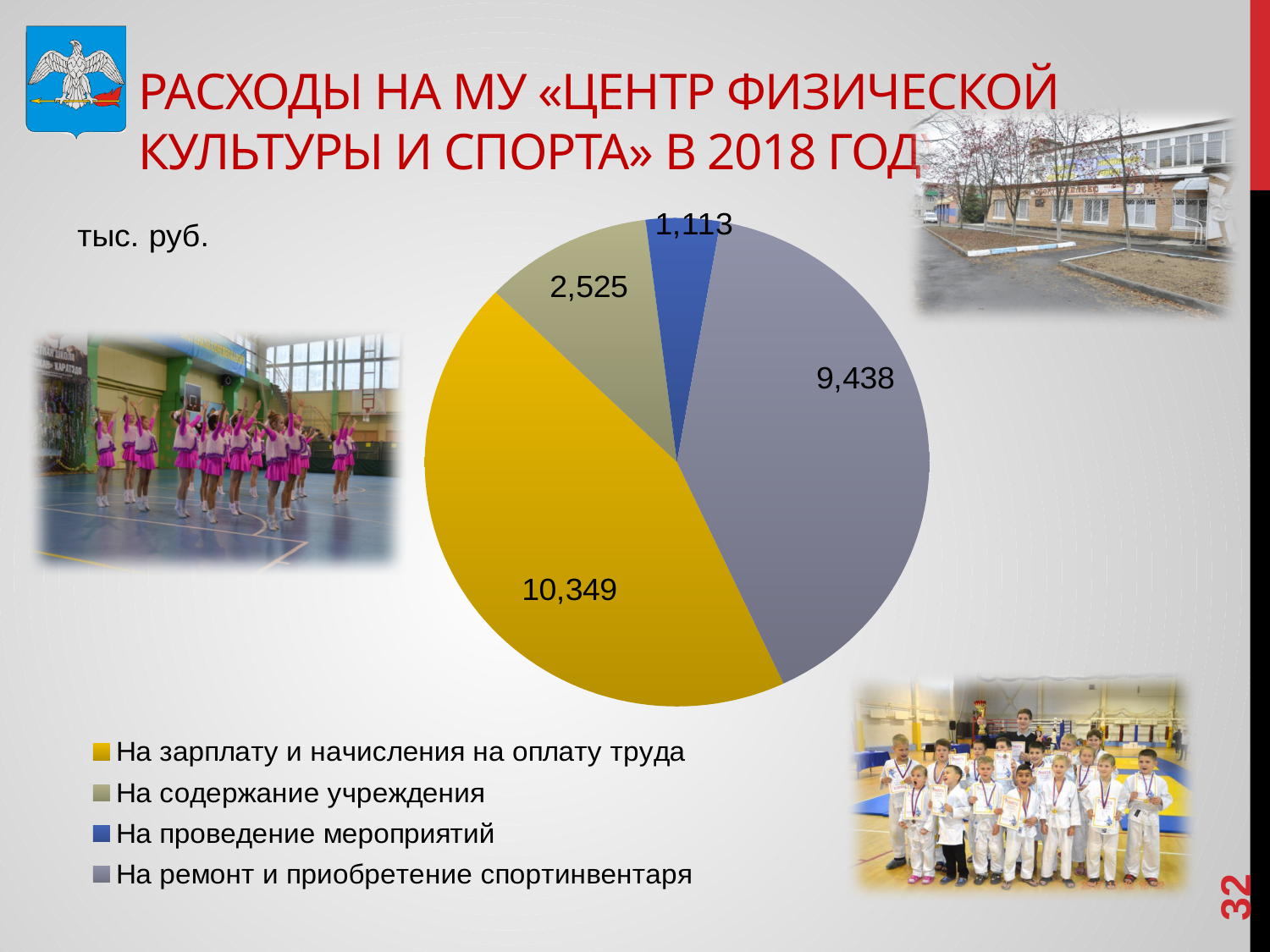
What is the difference between the values for «На зарплату и начисления на оплату труда» and «На ремонт и приобретение спортинвентаря»? 911 What unit is stated for the values in the chart? тыс. руб. Which category has the smallest slice of the pie? На проведение мероприятий What is the value for «На зарплату и начисления на оплату труда»? 10,349 What is the value for «На содержание учреждения»? 2,525 Which is larger: the value for «На содержание учреждения» or the value for «На проведение мероприятий»? На содержание учреждения What is the value for «На ремонт и приобретение спортинвентаря»? 9,438 How many slices does the pie chart have? 4 Which category has the largest slice of the pie? На зарплату и начисления на оплату труда What is the value for «На проведение мероприятий»? 1,113 What kind of chart is shown on the slide? pie chart What is the difference between the values for «На содержание учреждения» and «На проведение мероприятий»? 1,412